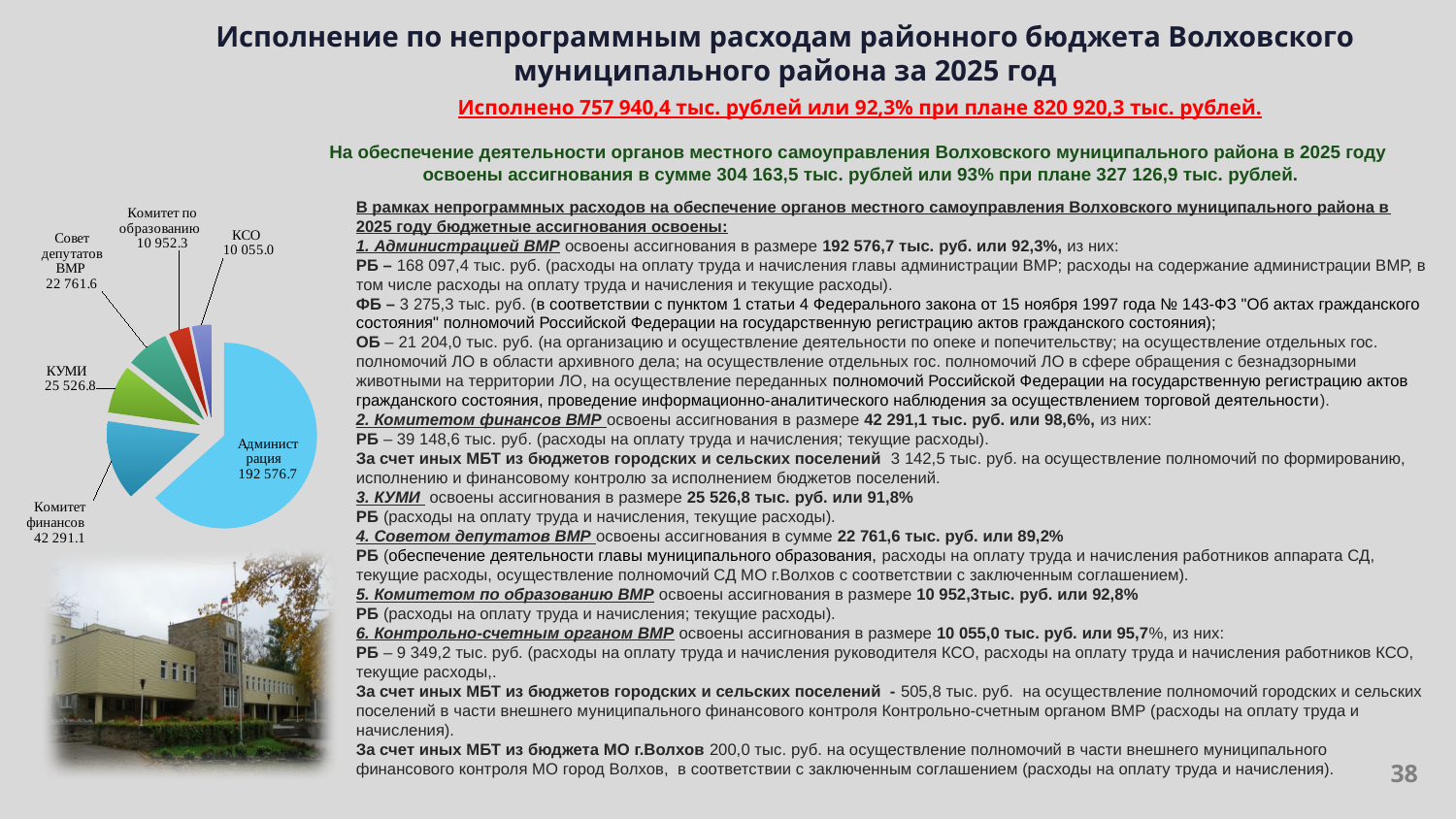
What type of chart is shown on the slide? pie chart What is the total of all slices in the pie chart? 304 163.5 What is the value shown for КУМИ in the pie chart? 25 526.8 What is the difference between the values for Администрация and Комитет финансов in the pie chart? 150 285.6 What is the value shown for КСО in the pie chart? 10 055.0 What is the value shown for the Администрация slice in the pie chart? 192 576.7 Which category has the smallest slice in the pie chart? КСО Which category has the largest slice in the pie chart? Администрация Which is larger in the pie chart: КУМИ or Совет депутатов ВМР? КУМИ How many slices does the pie chart have? 6 What is the difference between the values for Комитет по образованию ВМР and КСО in the pie chart? 897.3 What is the value shown for Комитет финансов in the pie chart? 42 291.1